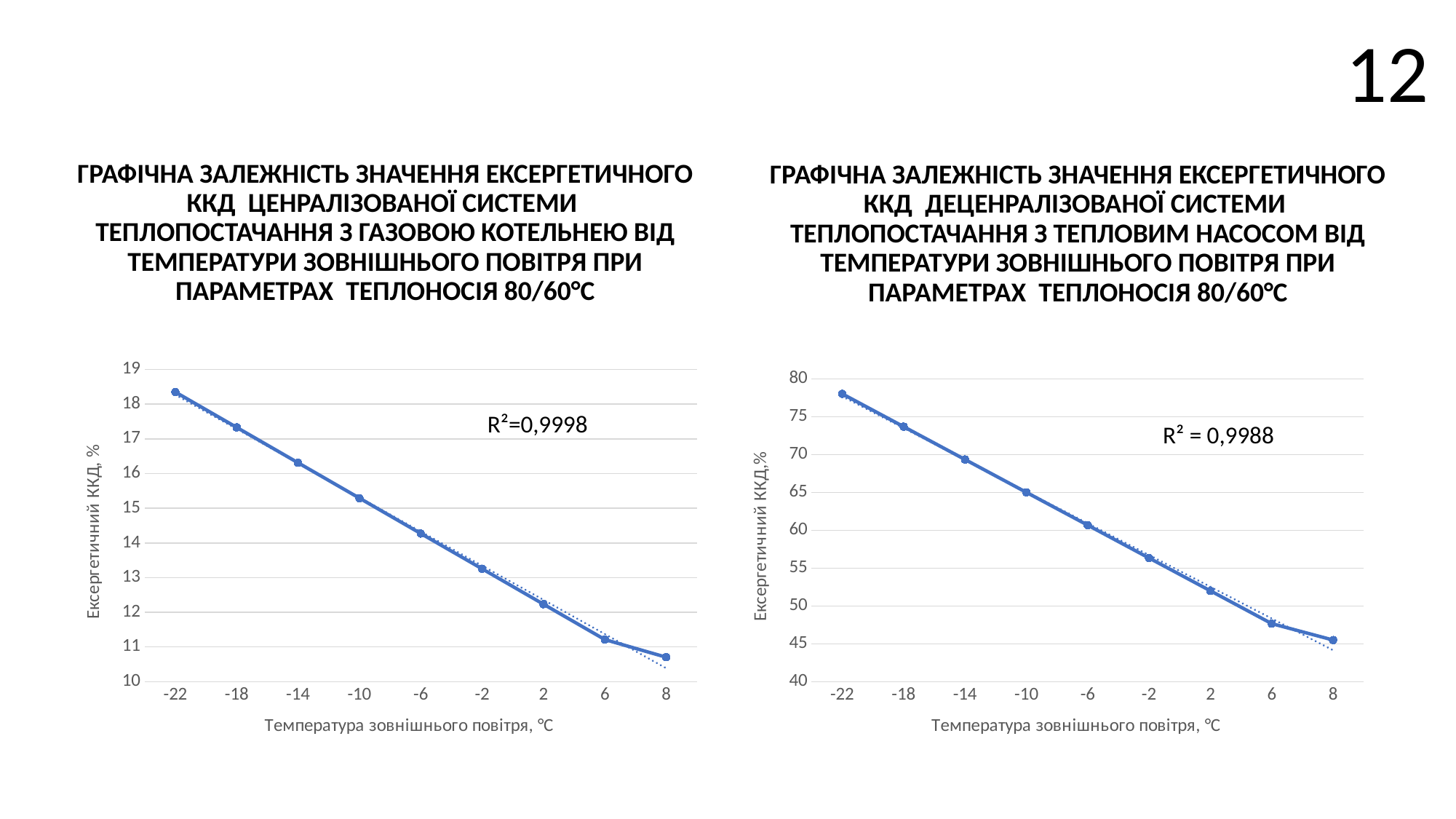
What kind of chart is the left chart (centralised system with gas boiler)? line chart What kind of chart is the right chart (decentralised system with heat pump)? line chart In the right chart, at which outdoor temperature is the exergy efficiency lowest? 8 In the left chart, how many outdoor temperature points are plotted along the x axis? 9 In the right chart, is the exergy efficiency at -10 °C greater or less than 60? greater In the right chart, does the exergy efficiency rise or fall as the outdoor temperature increases from -22 to 8? fall In the left chart, at which outdoor temperature is the exergy efficiency highest? -22 What R² value is shown on the right chart? R² = 0,9988 In the left chart, does the exergy efficiency rise or fall as the outdoor temperature increases from -22 to 8? fall In the right chart, how many outdoor temperature points are plotted along the x axis? 9 In the left chart, is the exergy efficiency at -22 °C greater or less than 18? greater In the right chart, which outdoor temperature has the larger exergy efficiency, -14 or 2? -14